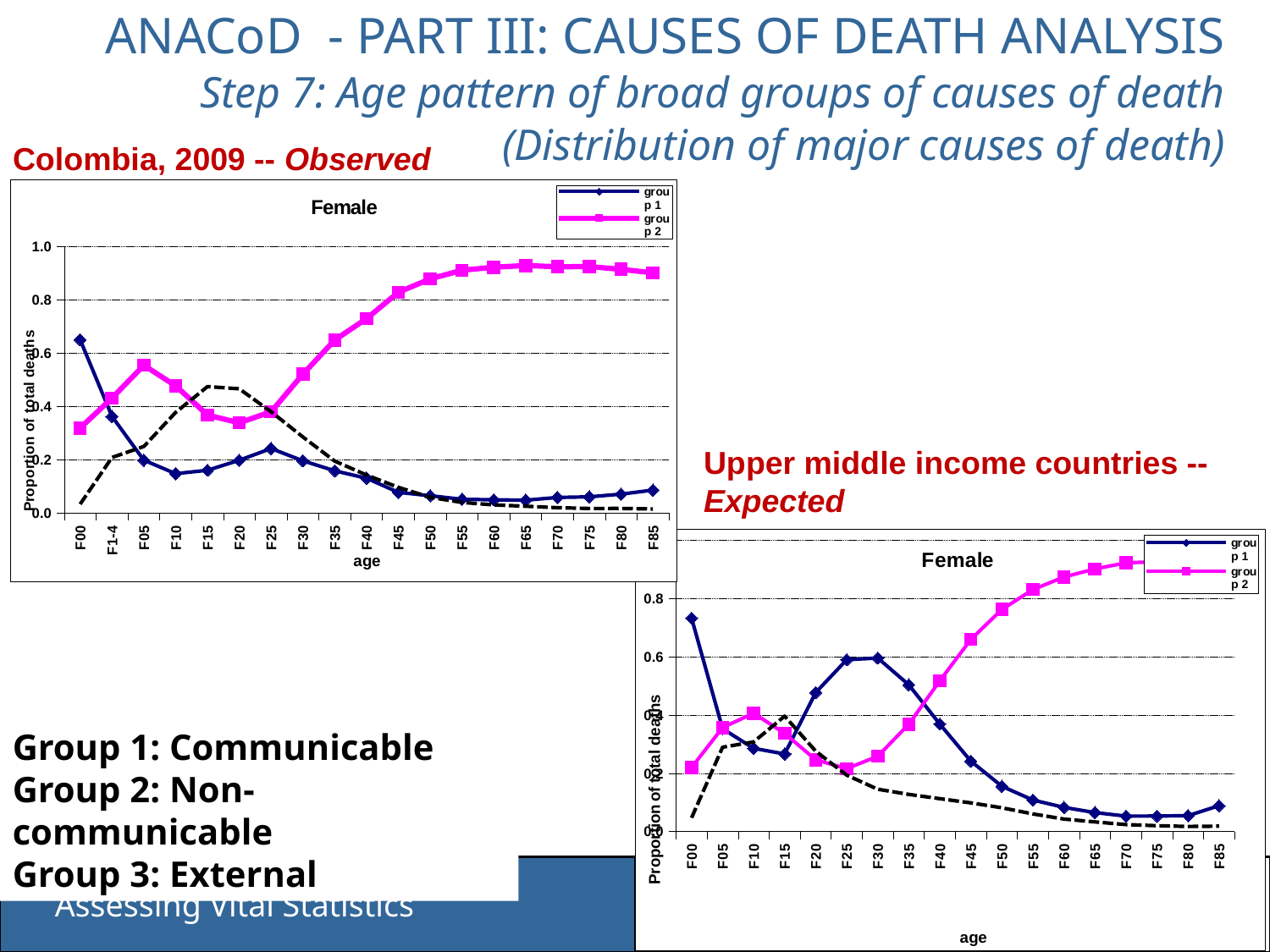
In the 'Upper middle income countries -- Expected' chart, which series has the larger value at F00, group 1 or group 2? group 1 How many age categories are shown on the x axis of the 'Colombia, 2009 -- Observed' chart? 19 In the 'Colombia, 2009 -- Observed' chart, does the group 2 line overall rise or fall from F00 to F85? rise What is the y-axis label of the 'Colombia, 2009 -- Observed' chart? Proportion of total deaths How many age categories are shown on the x axis of the 'Upper middle income countries -- Expected' chart? 18 How many series does the legend of the 'Colombia, 2009 -- Observed' chart list? 2 What kind of chart is the 'Colombia, 2009 -- Observed' chart on the left? line chart In the 'Upper middle income countries -- Expected' chart, is the value for group 1 at F00 greater or less than 0.6? greater In the 'Colombia, 2009 -- Observed' chart, is the value for group 2 at F00 greater or less than 0.4? less In the 'Colombia, 2009 -- Observed' chart, is the value for group 2 at F85 greater or less than 0.8? greater In the 'Colombia, 2009 -- Observed' chart, which series has the larger value at F85, group 1 or group 2? group 2